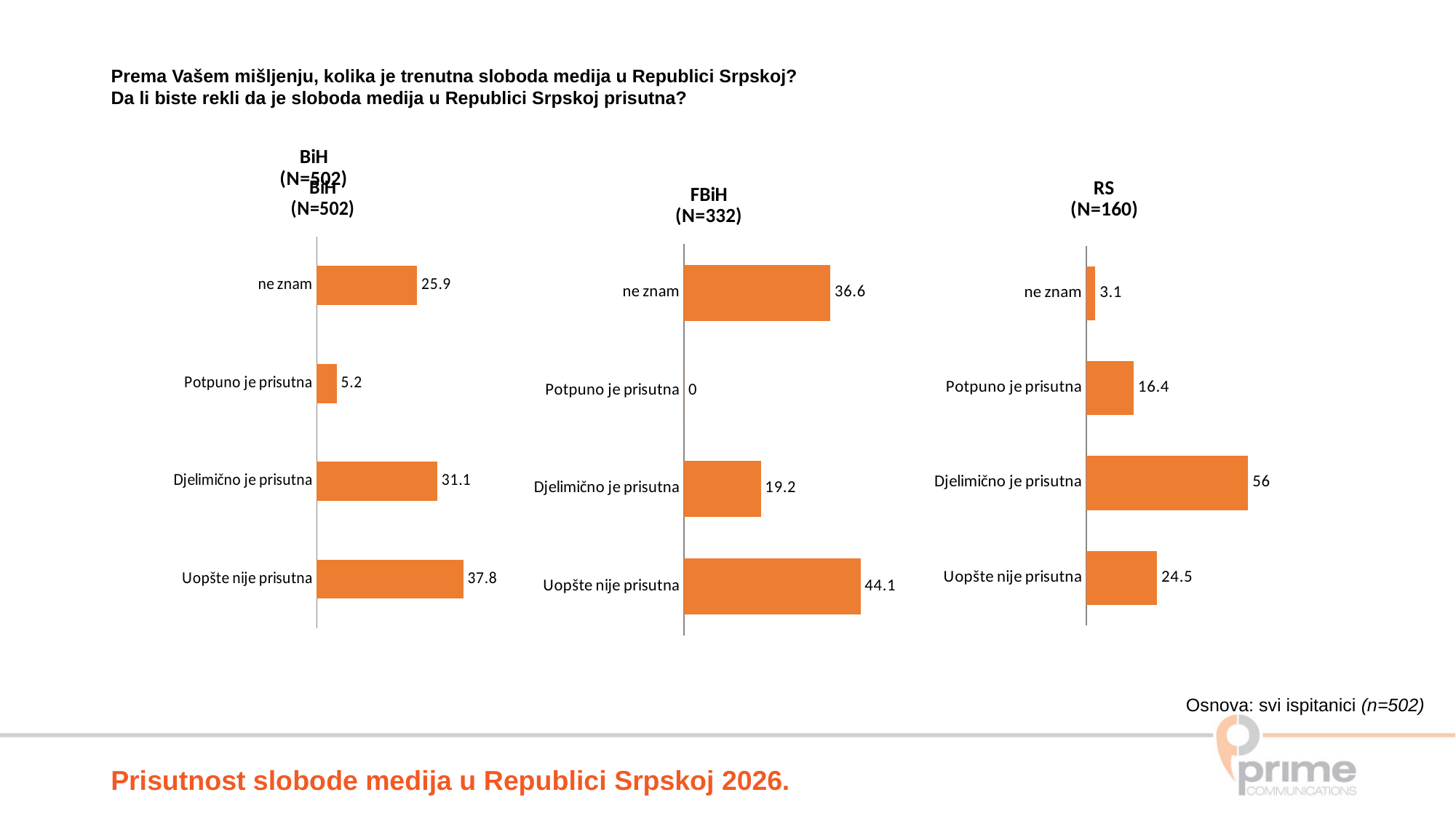
In the BiH (N=502) chart, which category has the lowest value? Potpuno je prisutna Which is larger: "ne znam" in the FBiH (N=332) chart or "ne znam" in the RS (N=160) chart? FBiH (N=332) How many charts are shown on the slide? 3 How many categories does the FBiH (N=332) chart show? 4 In the FBiH (N=332) chart, what is the value for "ne znam"? 36.6 In the RS (N=160) chart, what is the value for "Potpuno je prisutna"? 16.4 In the RS (N=160) chart, which category has the highest value? Djelimično je prisutna In the RS (N=160) chart, what is the difference between "Djelimično je prisutna" and "Uopšte nije prisutna"? 31.5 What type of chart is the RS (N=160) chart? Bar chart In the FBiH (N=332) chart, which category has the lowest value? Potpuno je prisutna In the BiH (N=502) chart, what is the difference between "Uopšte nije prisutna" and "Djelimično je prisutna"? 6.7 In the BiH (N=502) chart, what is the value for "Uopšte nije prisutna"? 37.8